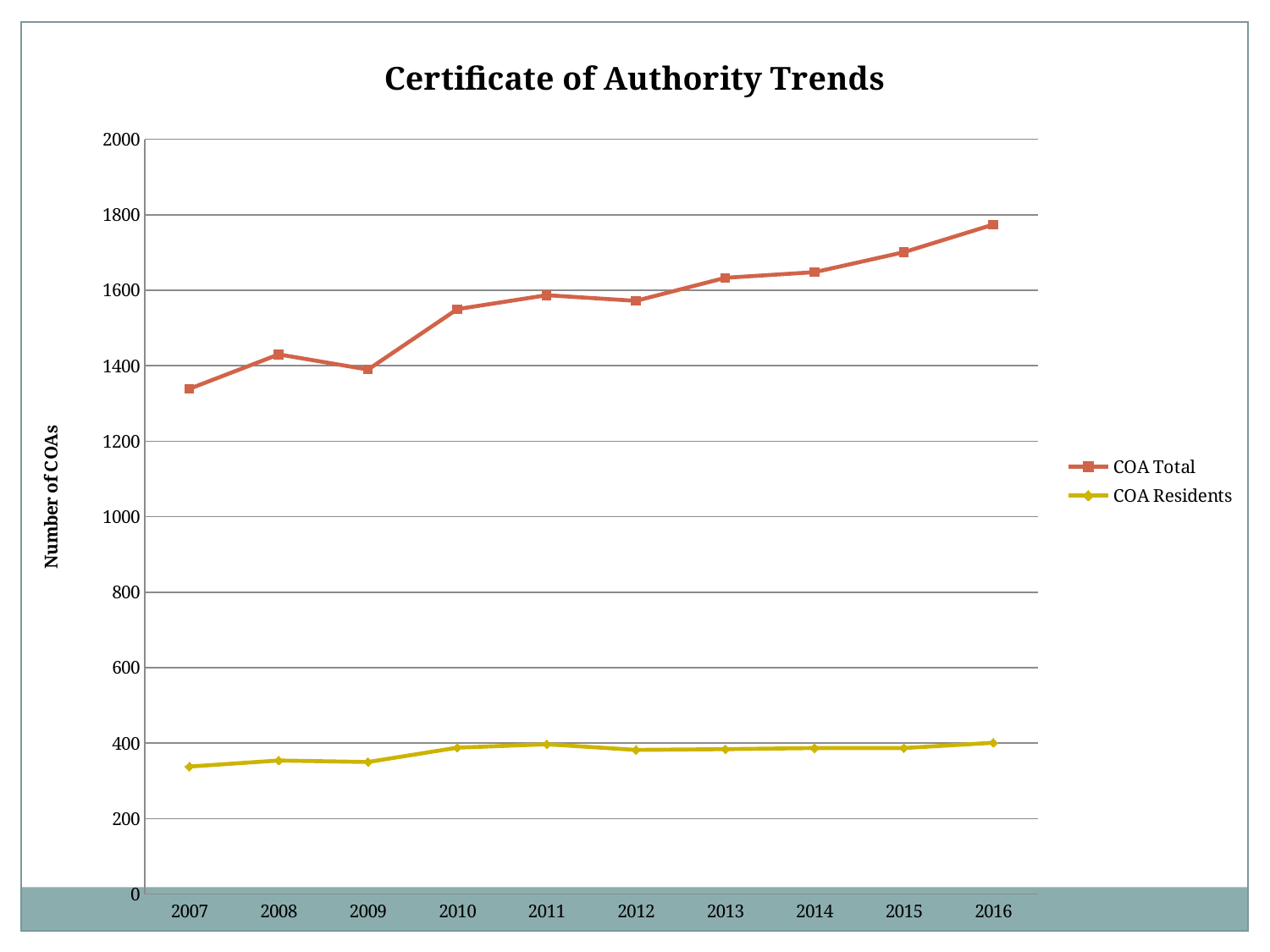
In which year is COA Total highest? 2016 In which year is COA Total lowest? 2007 In which year is COA Residents lowest? 2007 What is the title of the chart? Certificate of Authority Trends How many series does the legend list? 2 Is the COA Total value for 2016 greater or less than 1800? less How many years are plotted along the x axis? 10 Is the COA Total value for 2010 greater or less than 1400? greater Which year has the larger COA Total, 2008 or 2009? 2008 Is the COA Residents value for 2009 greater or less than 400? less What type of chart is shown on the slide? line chart